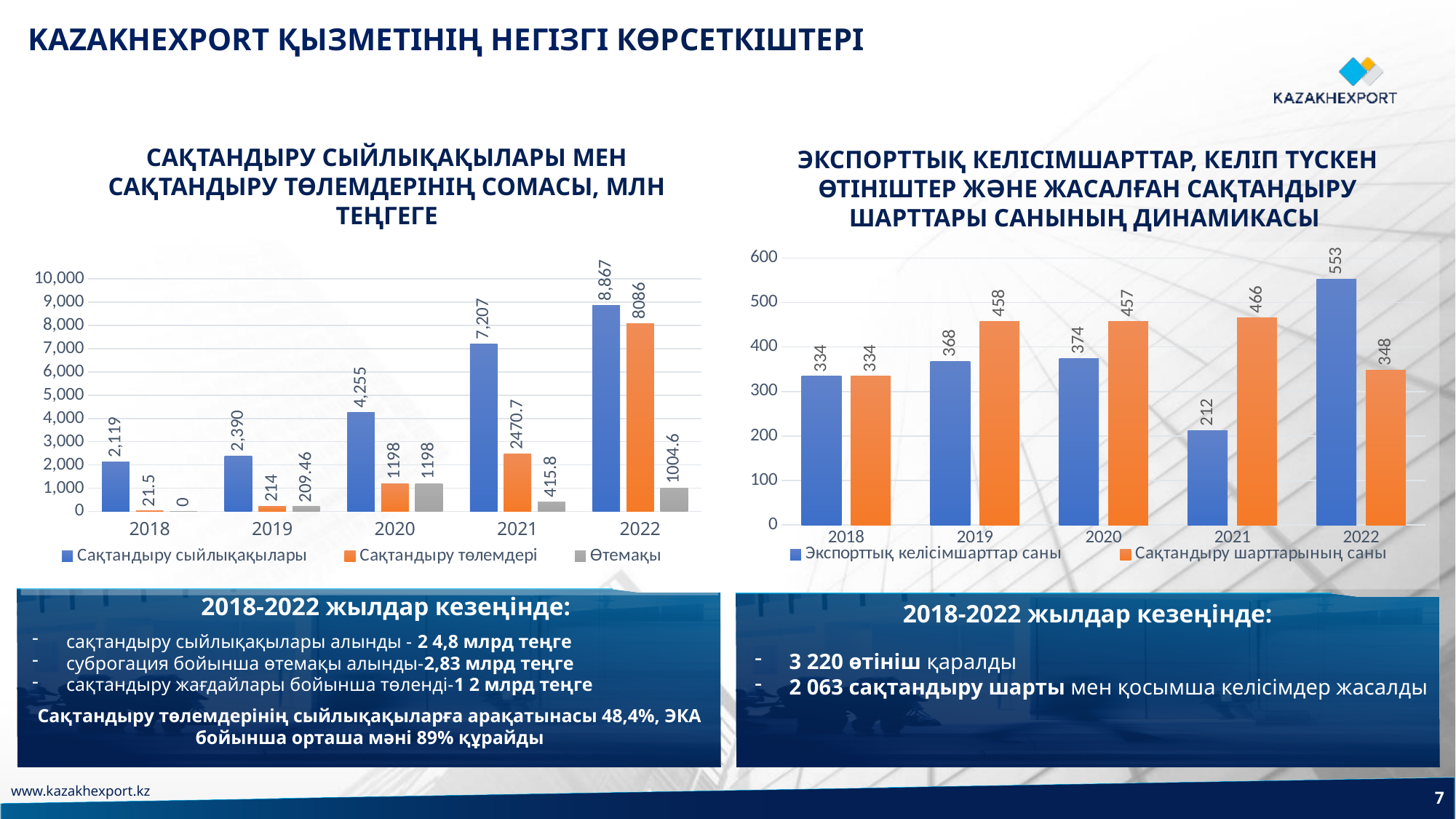
In the left chart, what is the value of Сақтандыру төлемдері for 2021? 2470.7 In the left chart, what is the value of Сақтандыру сыйлықақылары for 2022? 8,867 In the left chart, what is the value of Өтемақы for 2019? 209.46 In the right chart, what is the value of Экспорттық келісімшарттар саны for 2021? 212 In the right chart, which year has the highest value for Сақтандыру шарттарының саны? 2021 In the left chart, what is the difference between Сақтандыру сыйлықақылары and Сақтандыру төлемдері in 2022? 781 In the left chart, how many series does the legend list? 3 In the left chart, does the value of Сақтандыру сыйлықақылары rise or fall from 2018 to 2022? rise In the left chart, which year has the lowest value for Сақтандыру сыйлықақылары? 2018 In the right chart, what is the difference between Сақтандыру шарттарының саны and Экспорттық келісімшарттар саны in 2019? 90 What type of chart is the right chart? bar chart In the right chart, which is larger in 2022: Экспорттық келісімшарттар саны or Сақтандыру шарттарының саны? Экспорттық келісімшарттар саны